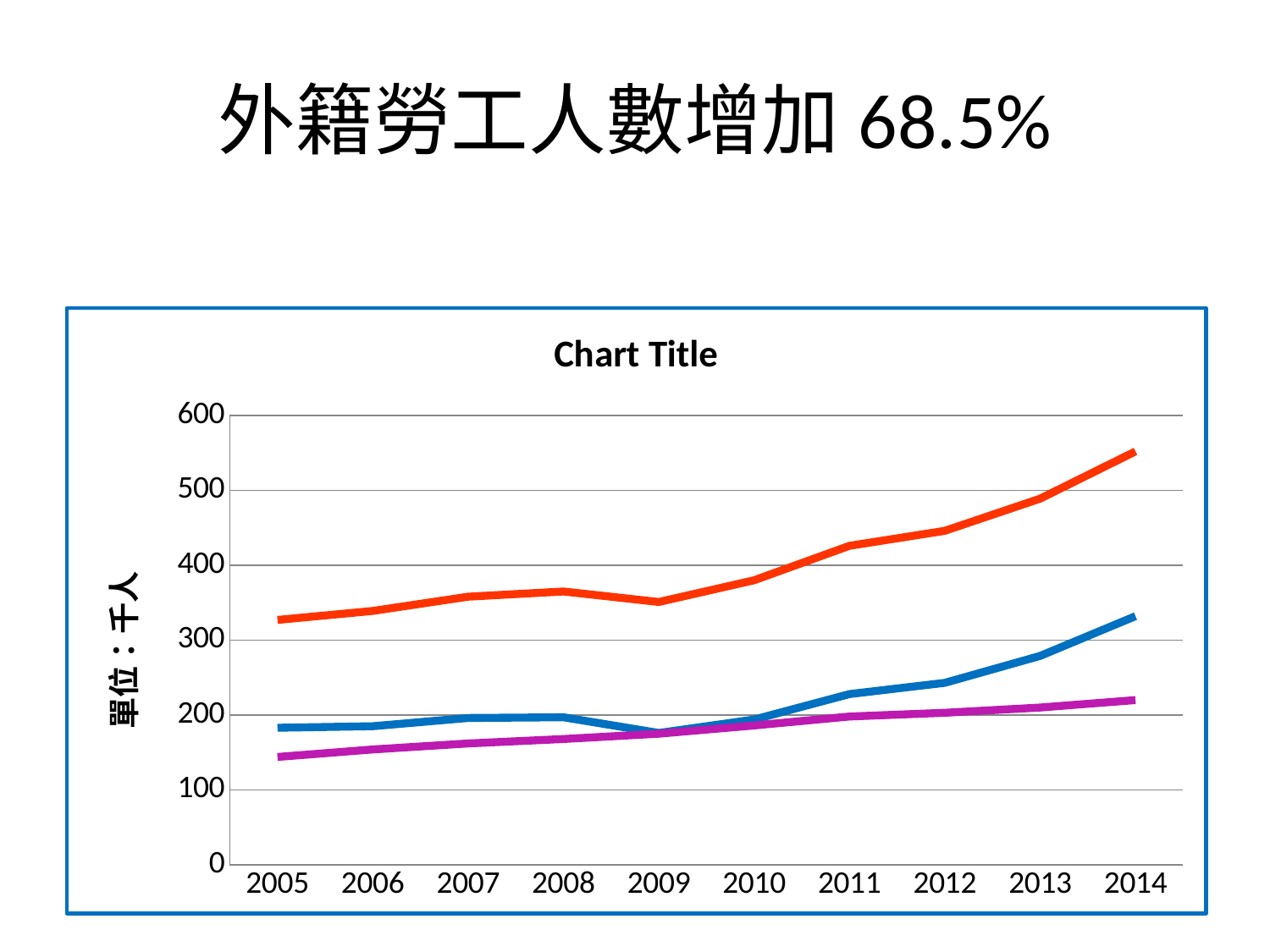
What is the first year shown on the x axis of the chart? 2005 Which coloured line has the lowest value in 2014? purple In 2010, which line has the larger value, the red line or the blue line? red Does the red line generally rise or fall from 2009 to 2014? rise How many years are shown along the x axis of the chart? 10 What is the last year shown on the x axis of the chart? 2014 Which coloured line has the highest value in 2014? red Is the value of the purple line in 2005 greater or less than 200? less Is the value of the blue line in 2014 greater or less than 300? greater What is the label on the vertical axis of the chart? 單位：千人 Is the value of the red line in 2014 greater or less than 500? greater What kind of chart is shown on the slide? line chart